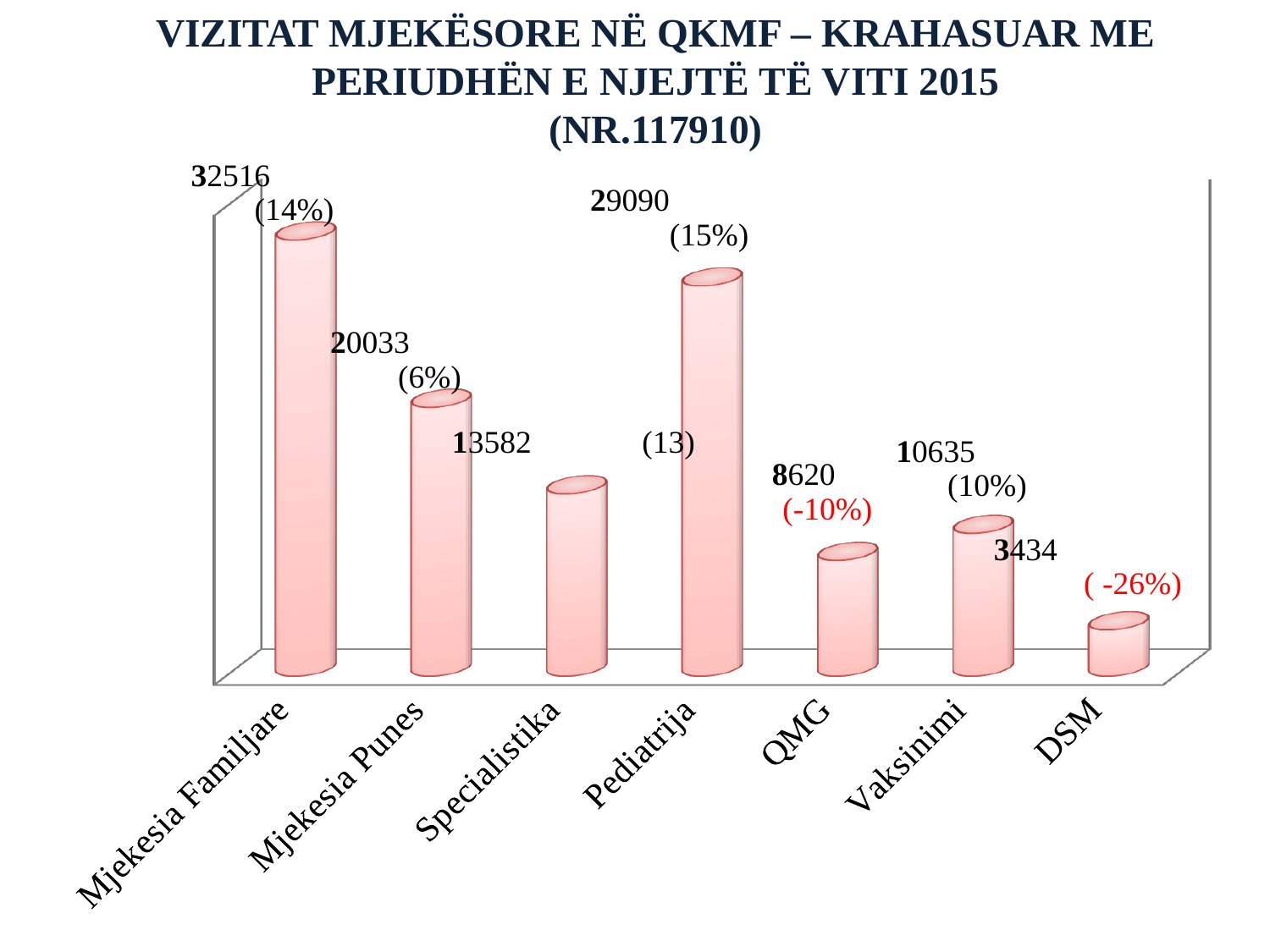
How many categories are shown on the x axis? 7 What is the value for Pediatrija? 29090 What total number is given in parentheses in the chart title? 117910 What is the difference between the values for Mjekesia Familjare and Pediatrija? 3426 Which is larger, the value for Mjekesia Punes or the value for Specialistika? Mjekesia Punes What percentage change is shown for DSM? -26% What is the value for DSM? 3434 Which category has the highest value? Mjekesia Familjare What is the value for QMG? 8620 Which category has the lowest value? DSM What is the value for Mjekesia Familjare? 32516 What kind of chart is shown on the slide? bar chart